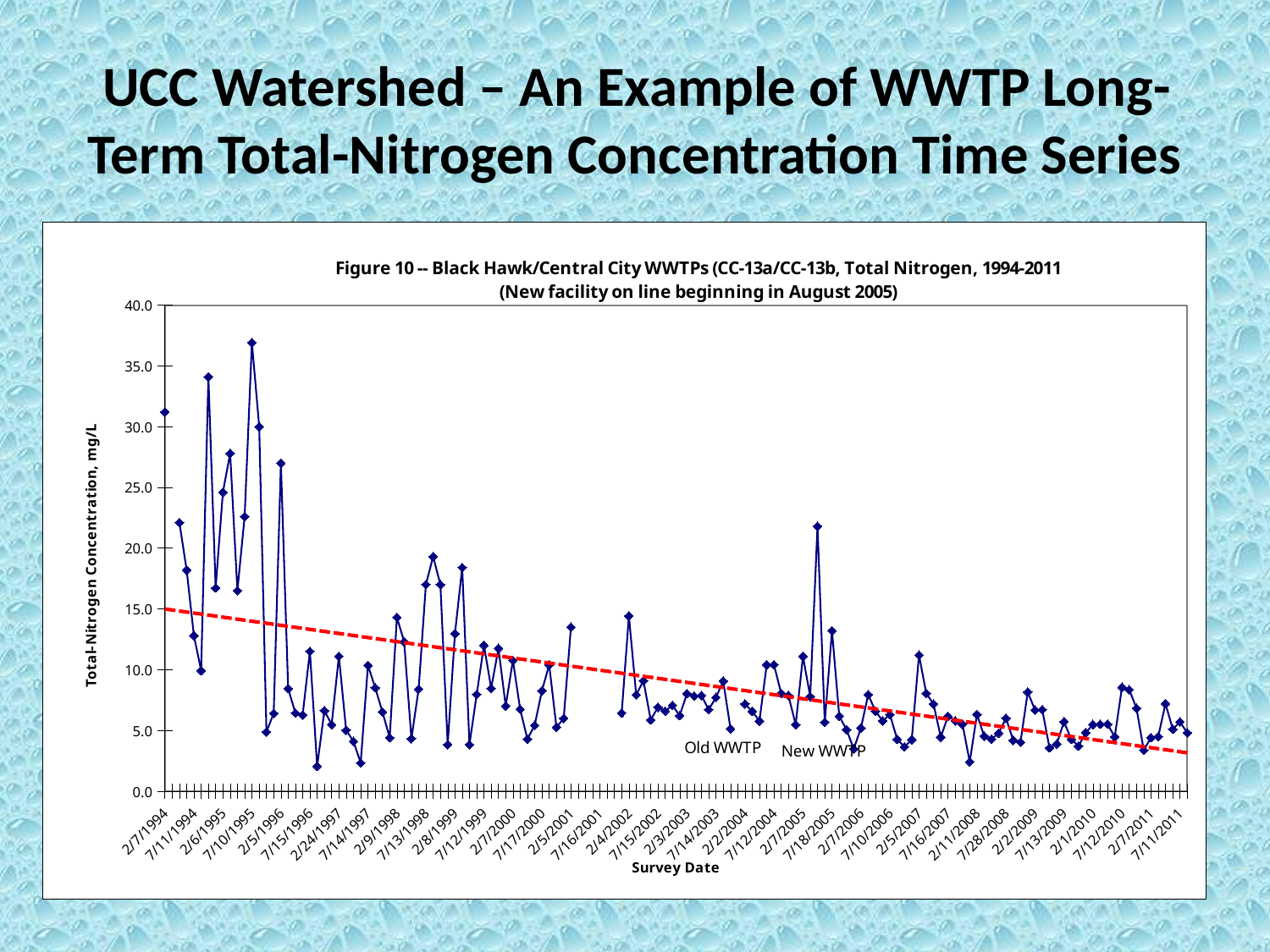
What is the maximum value shown on the y axis? 40.0 What kind of chart is shown on the slide? Line chart Is the highest total-nitrogen value plotted greater or less than 35.0? greater Do the total-nitrogen concentrations generally rise or fall from 1994 to 2011? Fall Is the first data point (2/7/1994) greater or less than 25.0? greater What is the label of the y axis? Total-Nitrogen Concentration, mg/L Is the spike in total nitrogen near 2005 greater or less than 15.0? greater Are the values in the 1994-1996 period generally higher or lower than the values in the 2008-2011 period? Higher